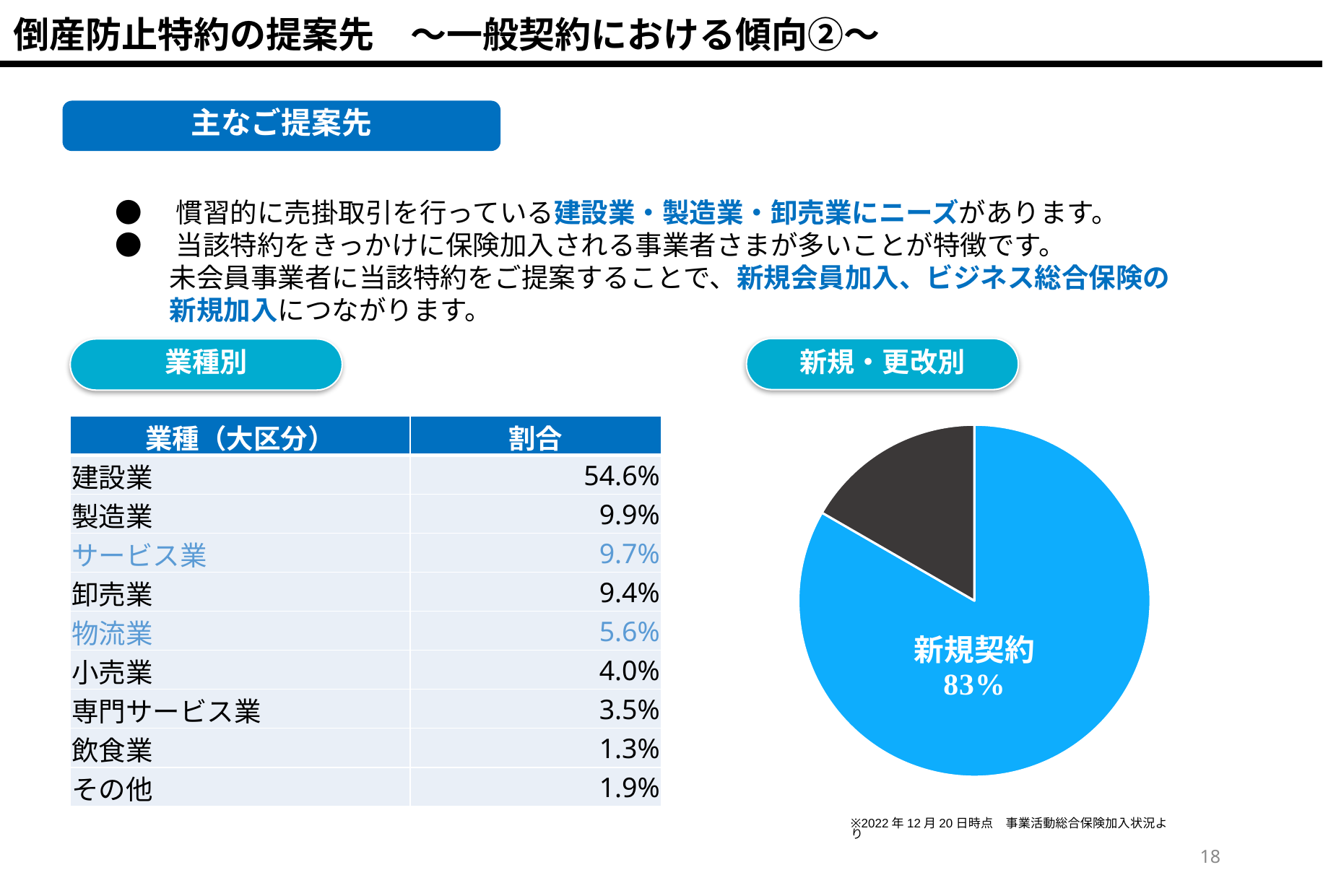
In the pie chart under 新規・更改別, what share is labelled for 新規契約? 83% In the pie chart under 新規・更改別, which slice is the largest? 新規契約 What colour is the 新規契約 slice in the pie chart under 新規・更改別? blue In the pie chart under 新規・更改別, is the 新規契約 slice larger or smaller than the dark grey slice? larger In the pie chart under 新規・更改別, is the share for 新規契約 greater or less than 50%? greater What kind of chart is shown under the heading 新規・更改別? pie chart How many slices does the pie chart under 新規・更改別 have? 2 What is the heading shown above the pie chart on the right of the slide? 新規・更改別